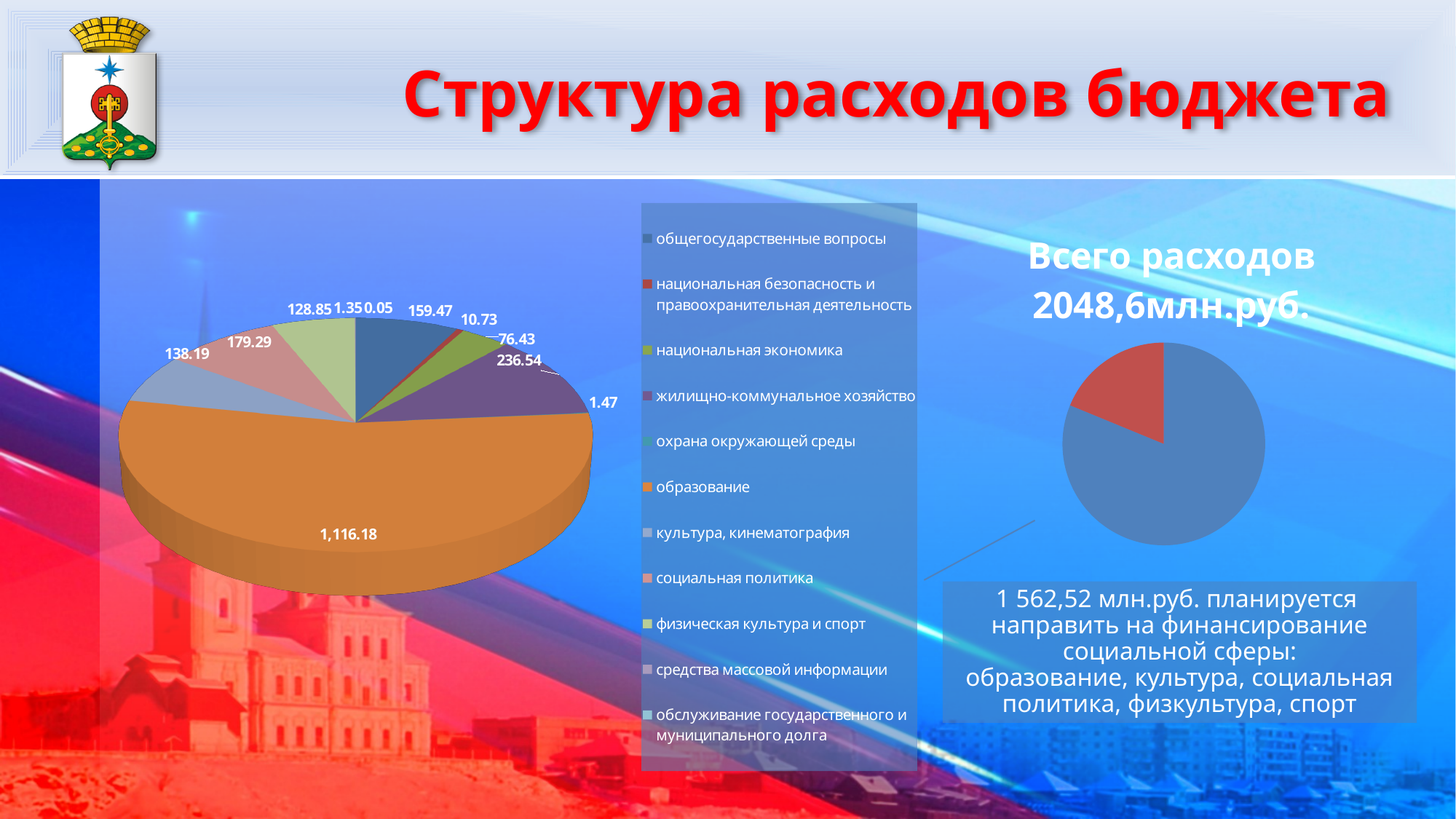
What total expenditure figure is stated next to the right-hand pie chart? 2048,6млн.руб. On the left pie chart, what is the value for жилищно-коммунальное хозяйство? 236.54 On the left pie chart, what is the value for общегосударственные вопросы? 159.47 On the left pie chart, what is the difference between the values for социальная политика and культура, кинематография? 41.10 What type of chart is shown on the left of the slide? pie chart On the left pie chart, which category has the largest slice? образование On the left pie chart, which category has the smallest value? обслуживание государственного и муниципального долга On the left pie chart, what is the value for национальная безопасность и правоохранительная деятельность? 10.73 On the left pie chart, what is the value for социальная политика? 179.29 How many categories does the legend of the left pie chart list? 11 On the left pie chart, what is the value for образование? 1,116.18 On the left pie chart, which is larger: национальная экономика or физическая культура и спорт? физическая культура и спорт